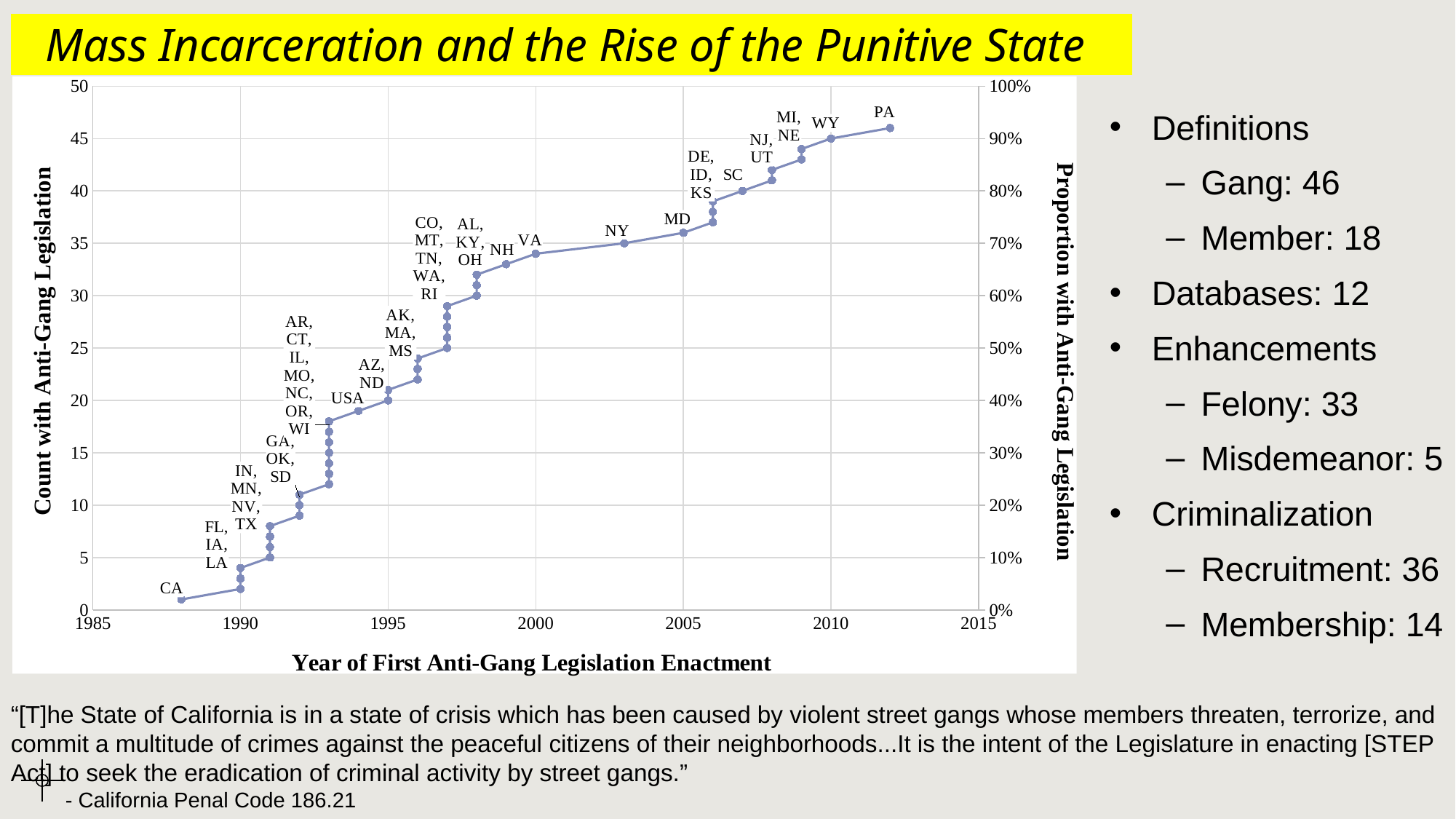
What kind of chart is shown on the slide? line chart Which state is labelled at the last (highest) point on the chart? PA Is the count at the point labelled VA greater or less than 30? greater What is the title of the left y axis of the chart? Count with Anti-Gang Legislation What is the count with anti-gang legislation at the point labelled NY? 35 What is the count with anti-gang legislation at the point labelled SC? 40 Does the count with anti-gang legislation rise or fall as the year increases? rise Which point has a higher count, the one labelled MD or the one labelled USA? MD Is the count at the point labelled CA greater or less than 5? less What is the title of the x axis of the chart? Year of First Anti-Gang Legislation Enactment What is the count with anti-gang legislation at the point labelled WY? 45 Which state is labelled at the first (earliest) point on the chart? CA